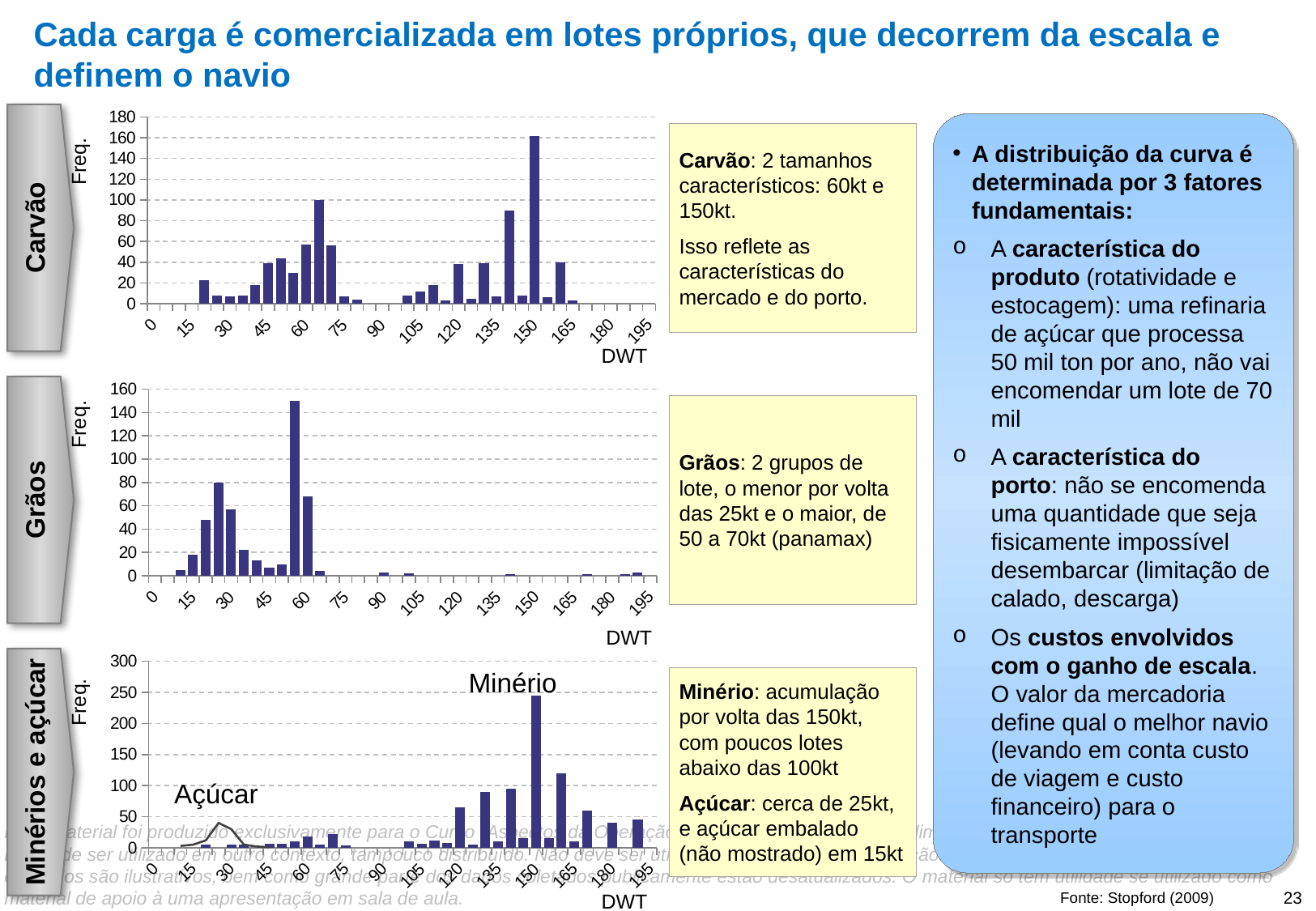
In the Minérios e açúcar chart, which is larger, the bar at 150 DWT or the bar at 165 DWT? 150 DWT What kind of chart is the Carvão chart? bar chart In the Carvão chart, is the value at 135 DWT greater or less than 80? less In the Carvão chart, is the value at 150 DWT greater or less than 140? greater In the Minérios e açúcar chart, is the value at 150 DWT greater or less than 200? greater In the Minérios e açúcar chart, at which DWT value is the tallest bar? 150 What is the label on the horizontal axis of the Grãos chart? DWT In the Carvão chart, which is larger, the bar at 150 DWT or the bar at 135 DWT? 150 DWT What is the label on the vertical axis of the Carvão chart? Freq. In the Carvão chart, at which DWT value is the tallest bar? 150